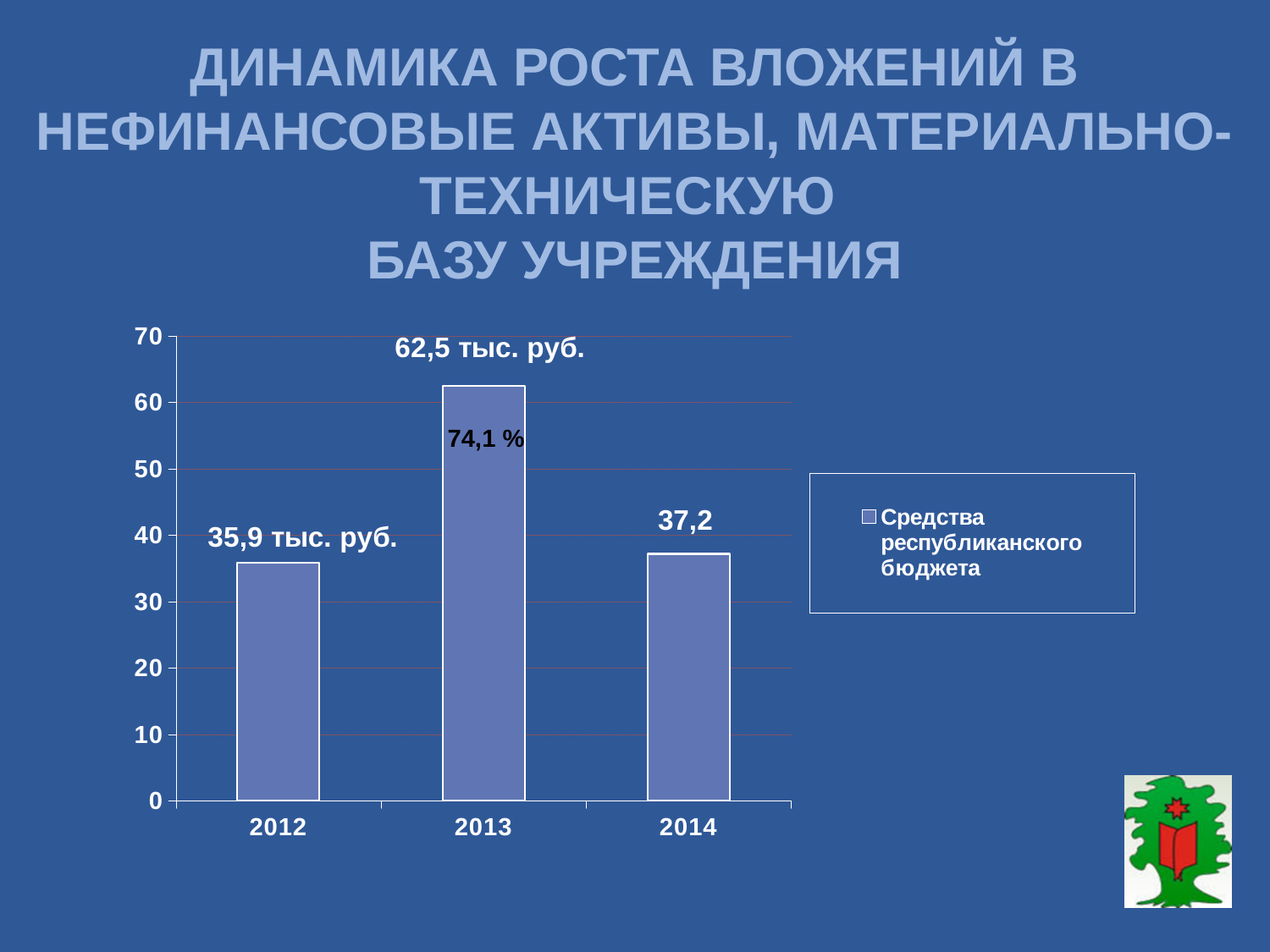
What value is shown for 2013? 62,5 тыс. руб. Is the value for 2013 greater or less than 60? greater What series does the legend list? Средства республиканского бюджета What value is shown for 2014? 37,2 Which is larger, the value for 2014 or the value for 2012? 2014 Which year has the lowest value? 2012 What is the difference between the values for 2013 and 2014? 25,3 What value is shown for 2012? 35,9 тыс. руб. What kind of chart is shown on the slide? bar chart How many years are shown on the x axis? 3 Which year has the highest value? 2013 What is the difference between the values for 2013 and 2012? 26,6